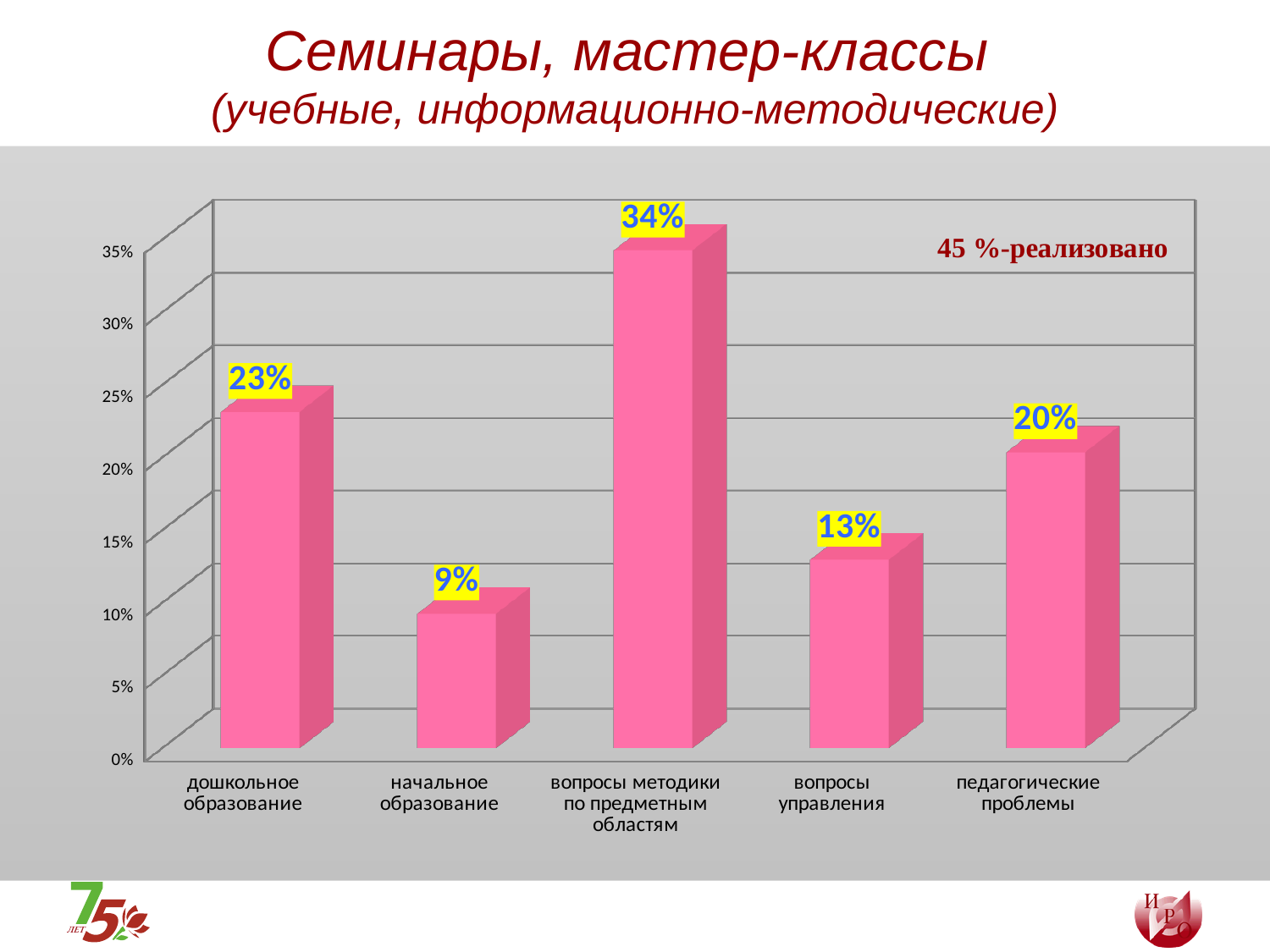
What is the difference between the values for вопросы методики по предметным областям and дошкольное образование? 11% What kind of chart is shown on the slide? bar chart Which is larger, the value for педагогические проблемы or the value for вопросы управления? педагогические проблемы What is the value for вопросы управления? 13% What percentage is stated as реализовано in the text on the chart? 45 % What is the value for дошкольное образование? 23% What is the value for педагогические проблемы? 20% Which category has the lowest value? начальное образование What is the value for начальное образование? 9% How many categories are shown on the chart? 5 Which category has the highest value? вопросы методики по предметным областям What is the value for вопросы методики по предметным областям? 34%